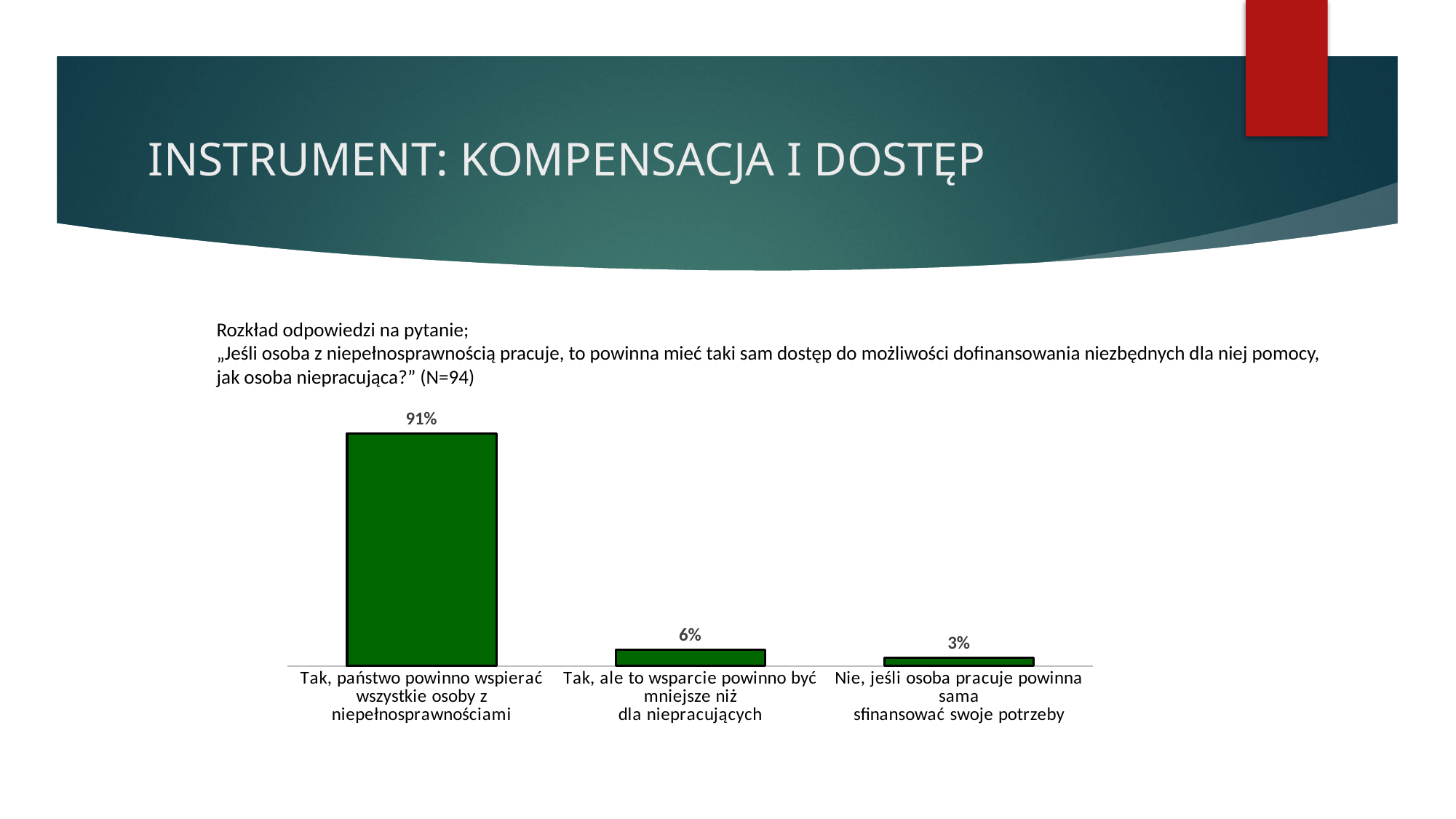
Which received a larger share: "Tak, ale to wsparcie powinno być mniejsze niż dla niepracujących" or "Nie, jeśli osoba pracuje powinna sama sfinansować swoje potrzeby"? Tak, ale to wsparcie powinno być mniejsze niż dla niepracujących How many answer options are shown in the chart? 3 What kind of chart is shown on the slide? Bar chart Do the values rise or fall from left to right across the answer options? Fall What percentage of respondents chose "Tak, państwo powinno wspierać wszystkie osoby z niepełnosprawnościami"? 91% What percentage of respondents chose "Tak, ale to wsparcie powinno być mniejsze niż dla niepracujących"? 6% Which answer option received the highest share of responses? Tak, państwo powinno wspierać wszystkie osoby z niepełnosprawnościami How many respondents (N) answered the question shown in the chart? 94 What is the difference in percentage points between "Tak, ale to wsparcie powinno być mniejsze niż dla niepracujących" and "Nie, jeśli osoba pracuje powinna sama sfinansować swoje potrzeby"? 3 What percentage of respondents chose "Nie, jeśli osoba pracuje powinna sama sfinansować swoje potrzeby"? 3% Which answer option received the lowest share of responses? Nie, jeśli osoba pracuje powinna sama sfinansować swoje potrzeby What is the difference in percentage points between the highest and lowest answer options? 88